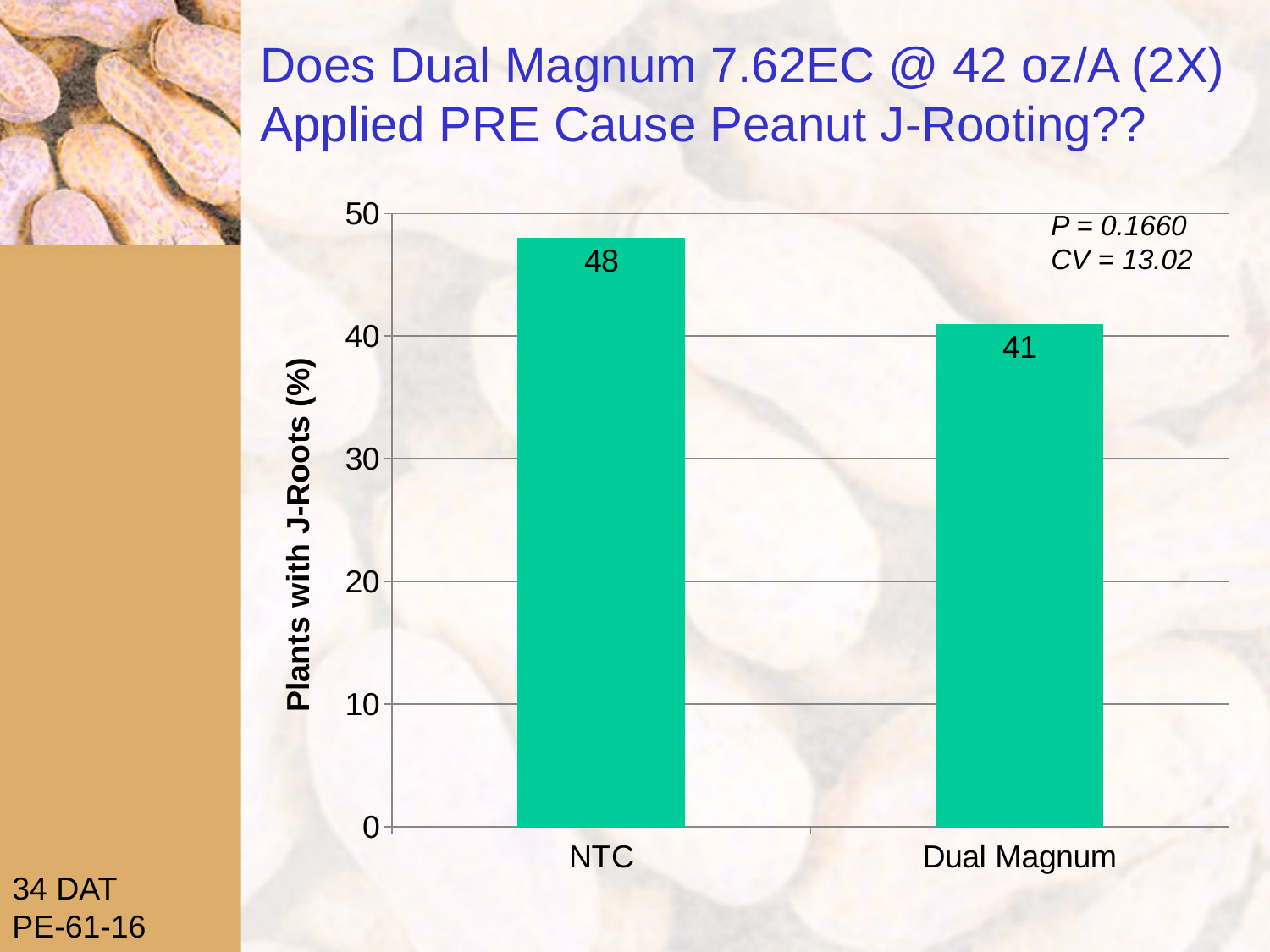
Is the value for Dual Magnum greater or less than 40? greater How many categories are shown on the x axis? 2 What P value is printed on the chart? P = 0.1660 What is the value for NTC? 48 Which category has the lowest percentage of plants with J-roots? Dual Magnum Which category has the highest percentage of plants with J-roots? NTC What is the value for Dual Magnum? 41 Which is larger, the value for NTC or the value for Dual Magnum? NTC What is the label of the y axis? Plants with J-Roots (%) What is the difference between the NTC and Dual Magnum values? 7 What kind of chart is shown on the slide? bar chart Is the value for NTC greater or less than 50? less